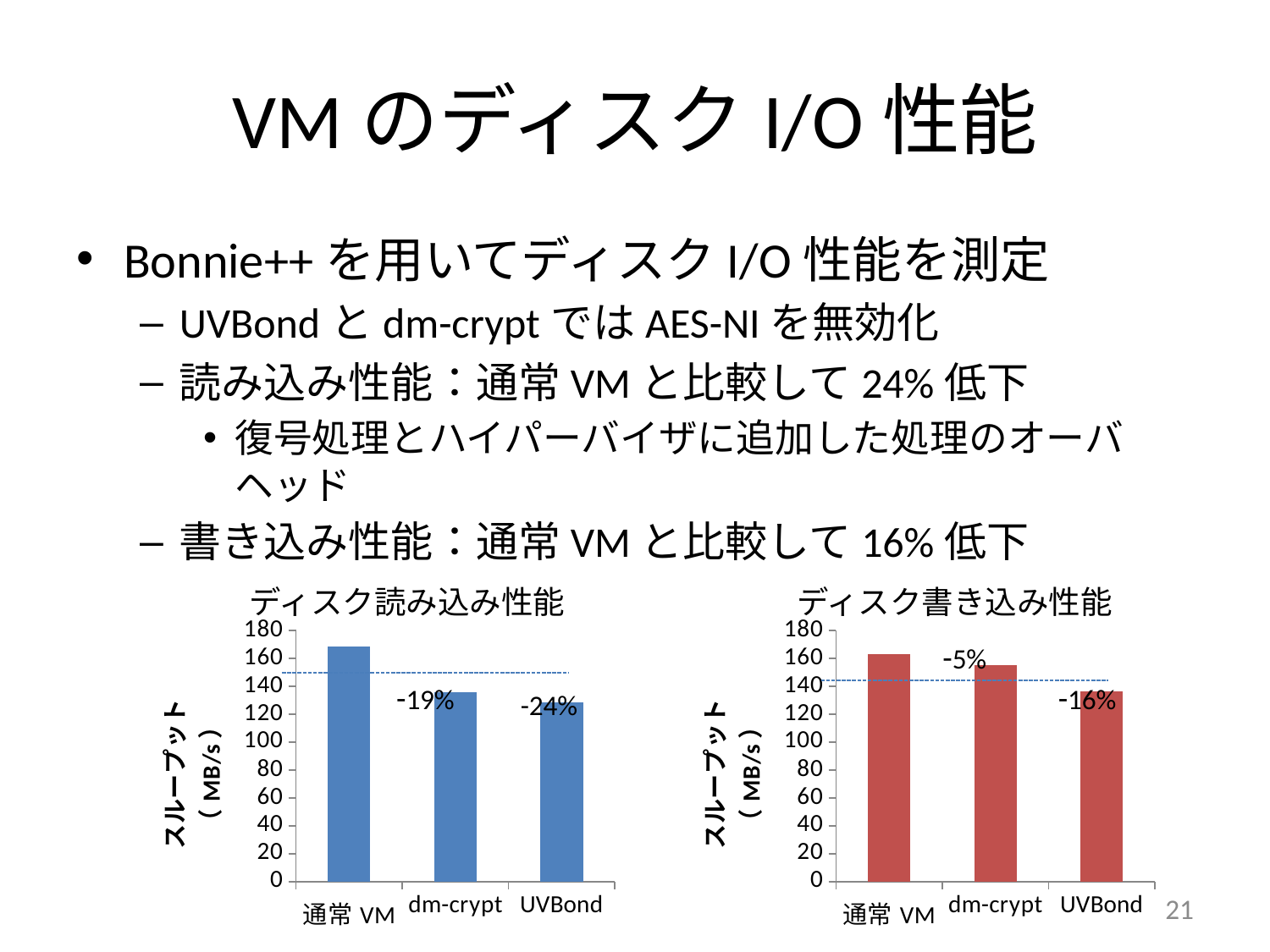
In the ディスク書き込み性能 chart, which category has the lowest throughput? UVBond In the ディスク書き込み性能 chart, what percentage label is shown above the dm-crypt bar? -5% In the ディスク読み込み性能 chart, which category has the lowest throughput? UVBond How many categories are shown on the x axis of the ディスク書き込み性能 chart? 3 In the ディスク読み込み性能 chart, is the value for 通常 VM greater or less than 160? greater In the ディスク読み込み性能 chart, what percentage label is shown above the dm-crypt bar? -19% In the ディスク書き込み性能 chart, is the value for dm-crypt greater or less than 140? greater In the ディスク読み込み性能 chart, what percentage label is shown above the UVBond bar? -24% What is the y-axis label of the ディスク書き込み性能 chart? スループット (MB/s) What kind of chart is the ディスク読み込み性能 chart? bar chart In the ディスク読み込み性能 chart, which category has the highest throughput? 通常 VM In the ディスク書き込み性能 chart, what percentage label is shown above the UVBond bar? -16%